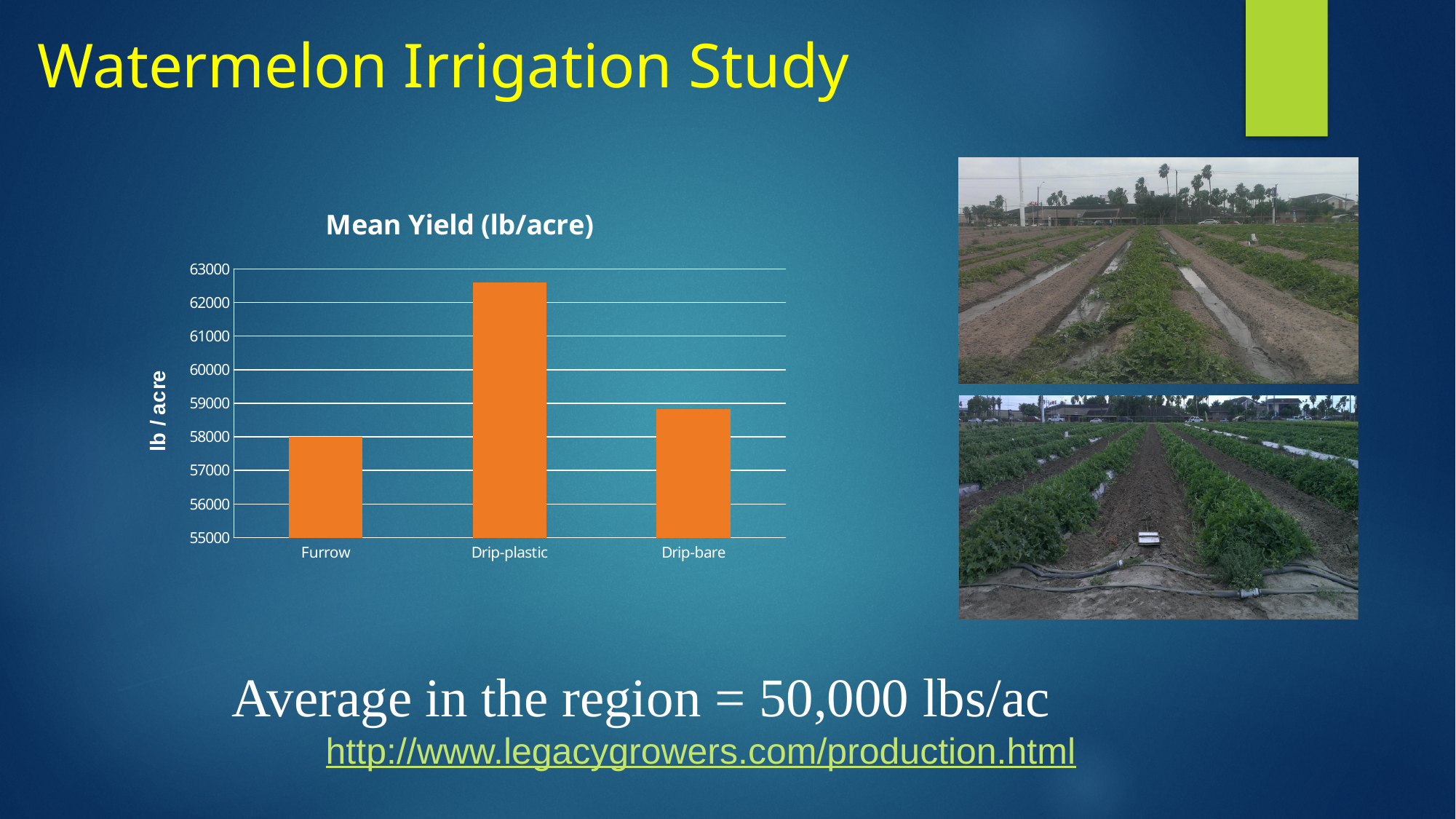
What is the mean yield for Furrow irrigation? 58000 Is the mean yield for Drip-bare greater or less than 58000? greater Is the mean yield for Drip-bare greater or less than 59000? less Which irrigation treatment has the highest mean yield? Drip-plastic What is the title of the chart? Mean Yield (lb/acre) Is the mean yield for Drip-plastic greater or less than 62000? greater Which has a higher mean yield, Furrow or Drip-bare? Drip-bare How many irrigation treatments (categories) are plotted in the chart? 3 What is the label on the vertical axis of the chart? lb / acre Which irrigation treatment has the lowest mean yield? Furrow What type of chart is shown on the slide? bar chart Which has a higher mean yield, Drip-plastic or Drip-bare? Drip-plastic